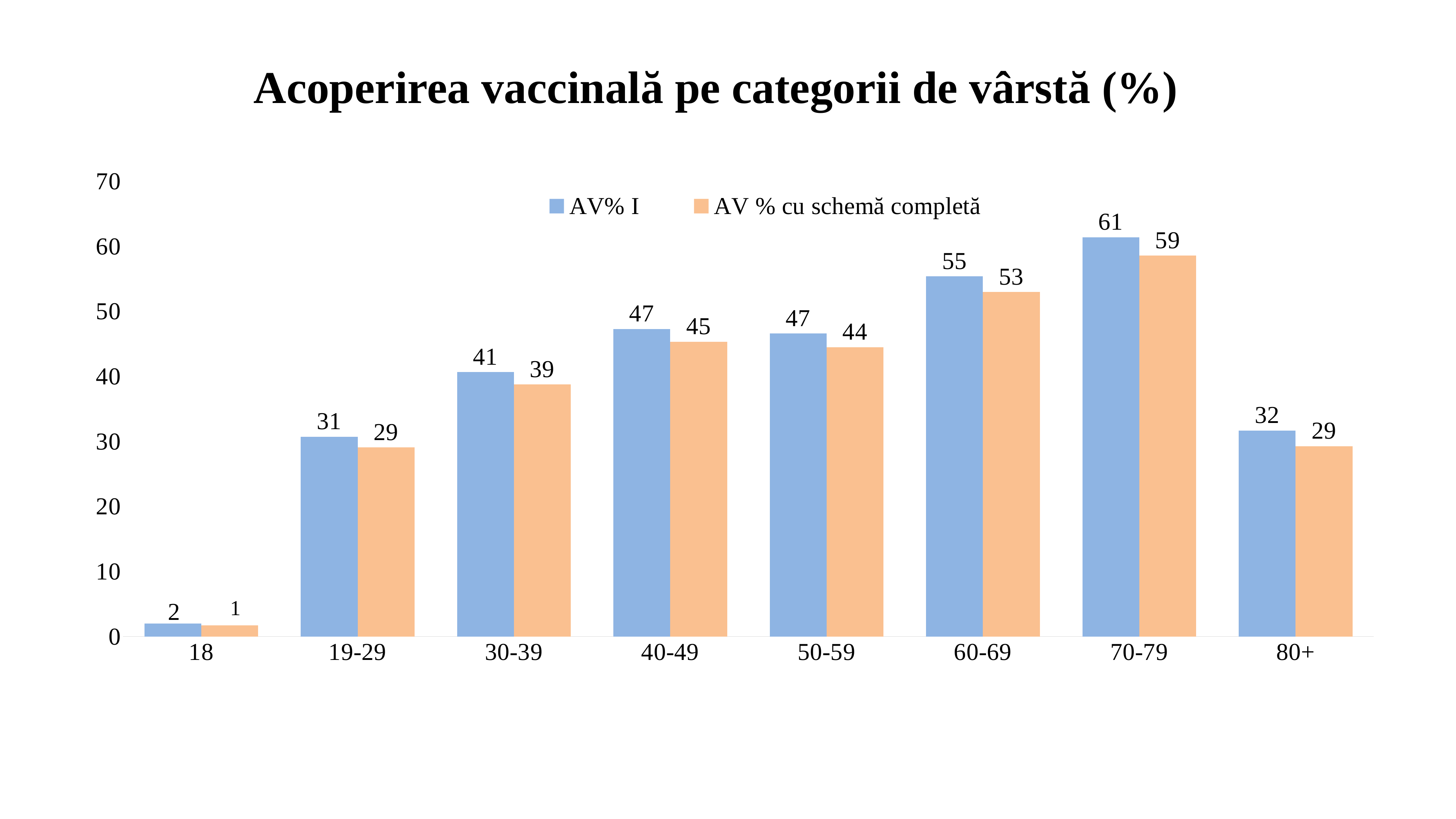
How many series does the legend list? 2 What kind of chart is shown on the slide? bar chart What is the AV% I value for the 18 age group? 2 What is the title of the chart? Acoperirea vaccinală pe categorii de vârstă (%) What is the difference between the AV% I and AV % cu schemă completă values for the 60-69 age group? 2 Which is larger: the AV% I value for 19-29 or the AV% I value for 80+? 80+ Which age group has the lowest AV % cu schemă completă value? 18 Which age group has the highest AV% I value? 70-79 What is the AV% I value for the 70-79 age group? 61 How many age groups are shown on the x axis? 8 Do the AV% I values rise or fall from the 18 age group to the 70-79 age group? rise What is the AV % cu schemă completă value for the 30-39 age group? 39